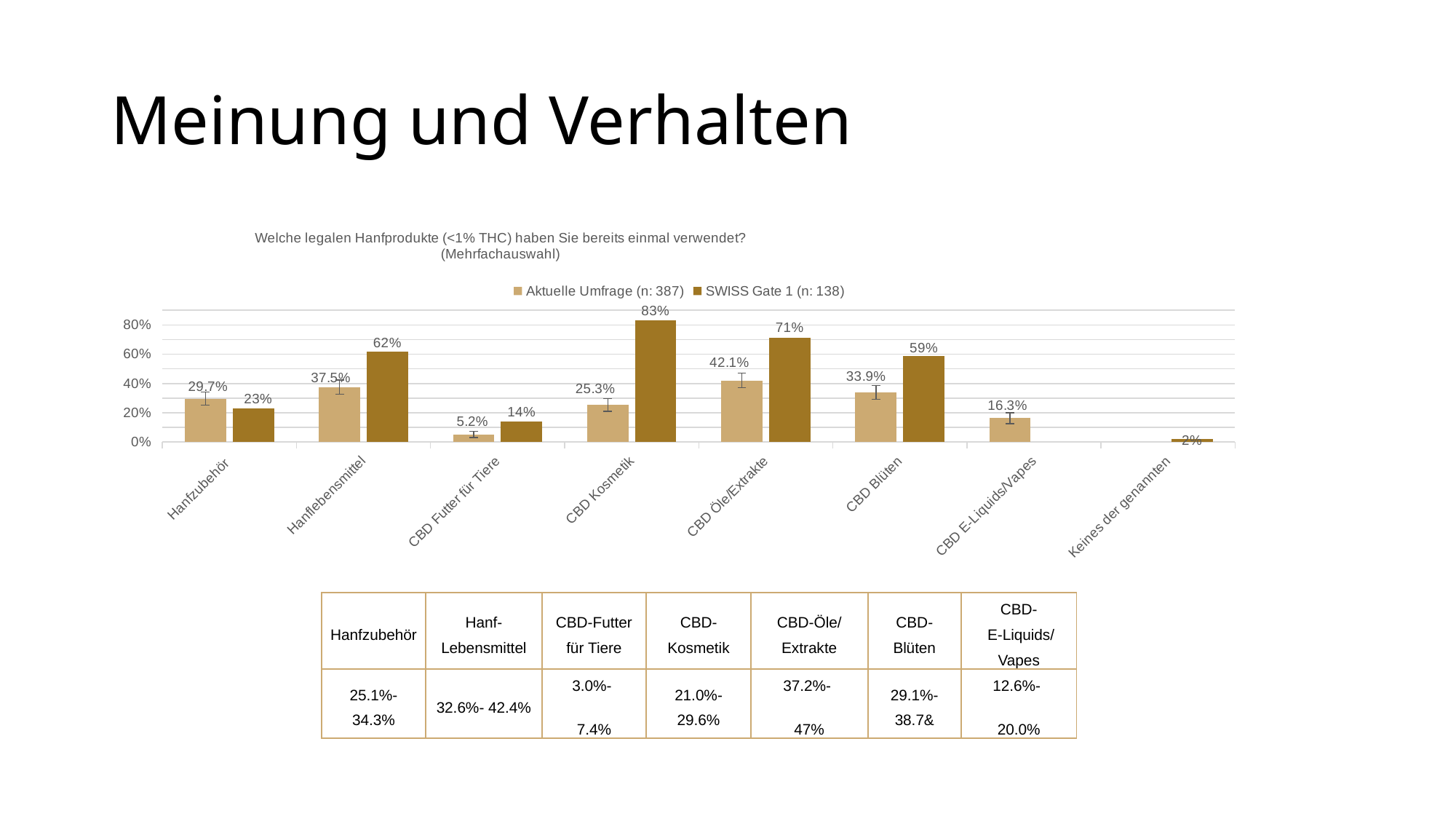
What is the value for CBD Futter für Tiere in the Aktuelle Umfrage (n: 387) series? 5.2% What is the value for CBD Öle/Extrakte in the Aktuelle Umfrage (n: 387) series? 42.1% What is the difference between the SWISS Gate 1 and Aktuelle Umfrage values for Hanflebensmittel? 24.5% How many series does the chart legend list? 2 What kind of chart is shown on the slide? Bar chart Which category has the lowest value in the Aktuelle Umfrage (n: 387) series among those with a bar? CBD Futter für Tiere For Hanfzubehör, which series has the larger value: Aktuelle Umfrage (n: 387) or SWISS Gate 1 (n: 138)? Aktuelle Umfrage (n: 387) Is the SWISS Gate 1 value for CBD Blüten greater or less than 40%? greater What is the value for Keines der genannten in the SWISS Gate 1 (n: 138) series? 2% How many categories are shown on the x axis of the chart? 8 Which category has the highest value in the SWISS Gate 1 (n: 138) series? CBD Kosmetik What is the value for CBD Kosmetik in the SWISS Gate 1 (n: 138) series? 83%